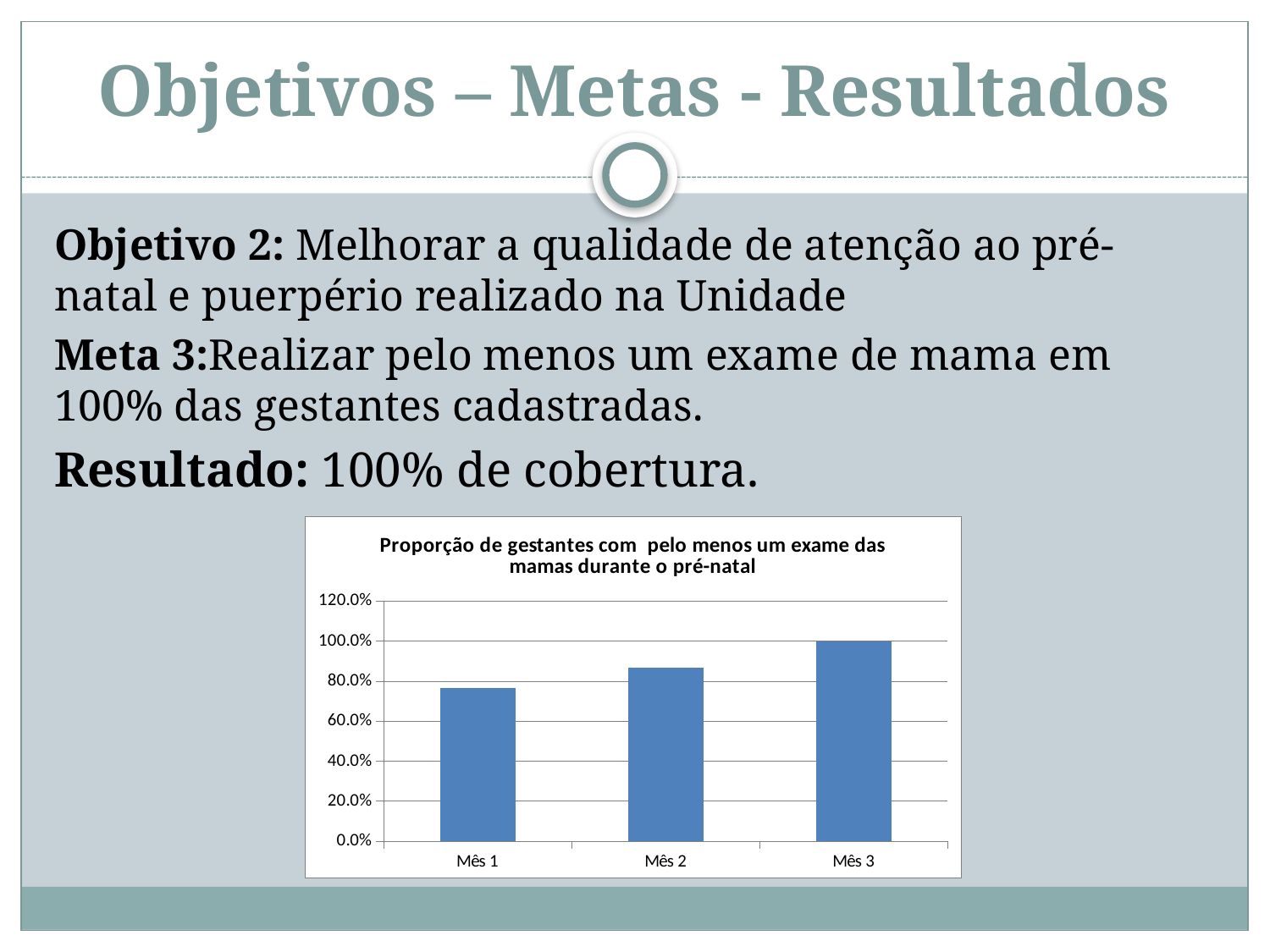
What is the value for Mês 3 in the chart? 100.0% What is the highest value shown on the y axis of the chart? 120.0% Is the value for Mês 1 greater or less than 60.0%? greater What is the title of the chart? Proporção de gestantes com pelo menos um exame das mamas durante o pré-natal How many categories are plotted on the x axis of the chart? 3 Is the value for Mês 2 greater or less than 80.0%? greater Is the value for Mês 1 greater or less than 80.0%? less Which month has the lowest value in the chart? Mês 1 Which month has the highest value in the chart? Mês 3 What kind of chart is shown on the slide? bar chart Do the values rise or fall from Mês 1 to Mês 3? rise Which is larger, the value for Mês 1 or the value for Mês 2? Mês 2